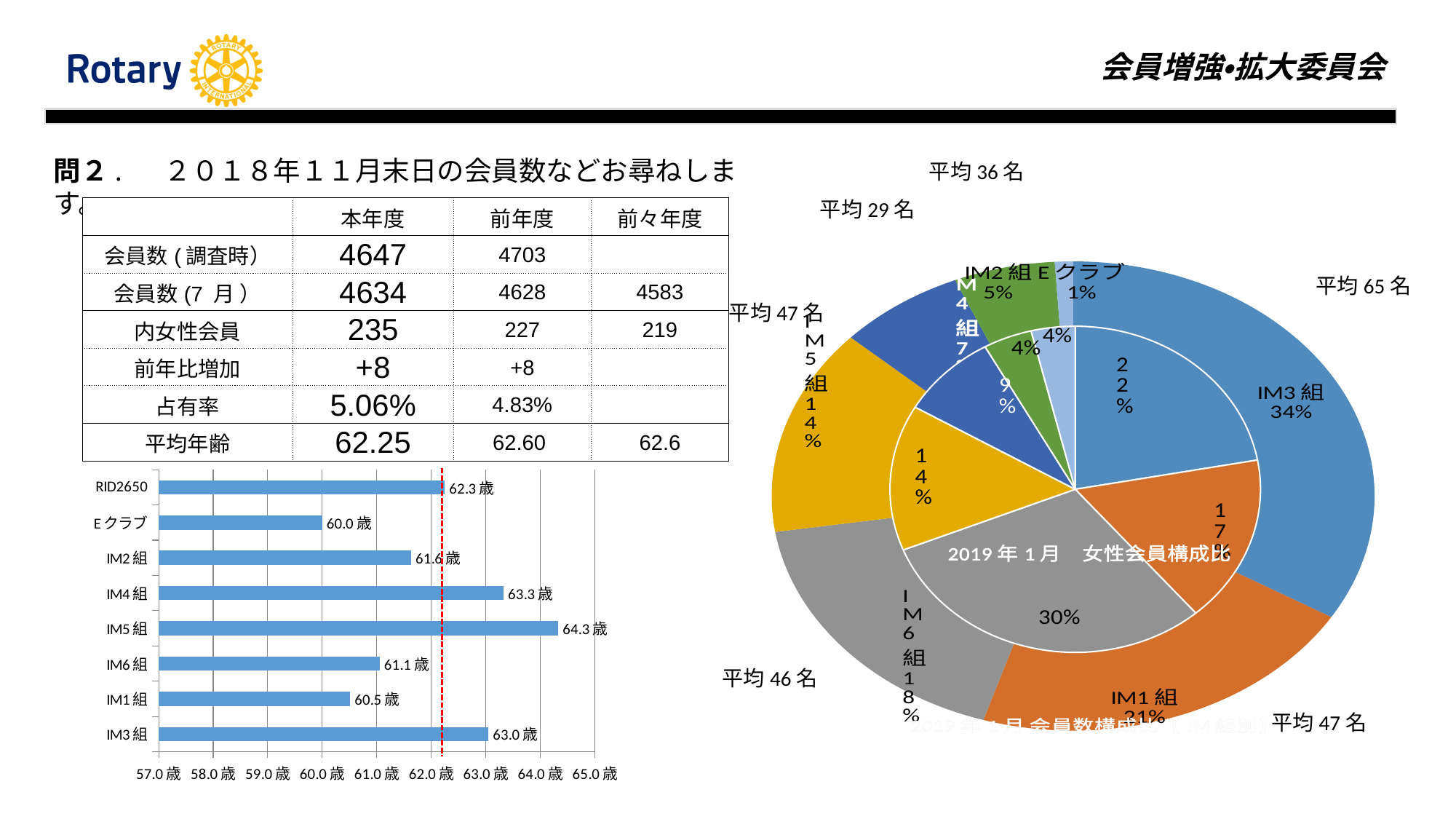
In the pie chart on the right (2019年1月 会員数構成比（IM組別）), what share does IM3組 have? 34% In the bar chart on the left, which category has the highest value? IM5組 In the bar chart on the left, which category has the lowest value? Eクラブ What kind of chart is the chart on the left of the slide? bar chart In the bar chart on the left, which is larger, the value for IM2組 or the value for IM6組? IM2組 In the bar chart on the left, what is the value for Eクラブ? 60.0歳 In the bar chart on the left, what is the value for RID2650? 62.3歳 In the bar chart on the left, what is the value for IM5組? 64.3歳 How many categories are shown in the bar chart on the left? 8 In the pie chart on the right (2019年1月 会員数構成比（IM組別）), which group has the smallest share? Eクラブ In the pie chart on the right (2019年1月 会員数構成比（IM組別）), what share does IM1組 have? 21% In the bar chart on the left, what is the difference between the values for IM4組 and IM1組? 2.8歳